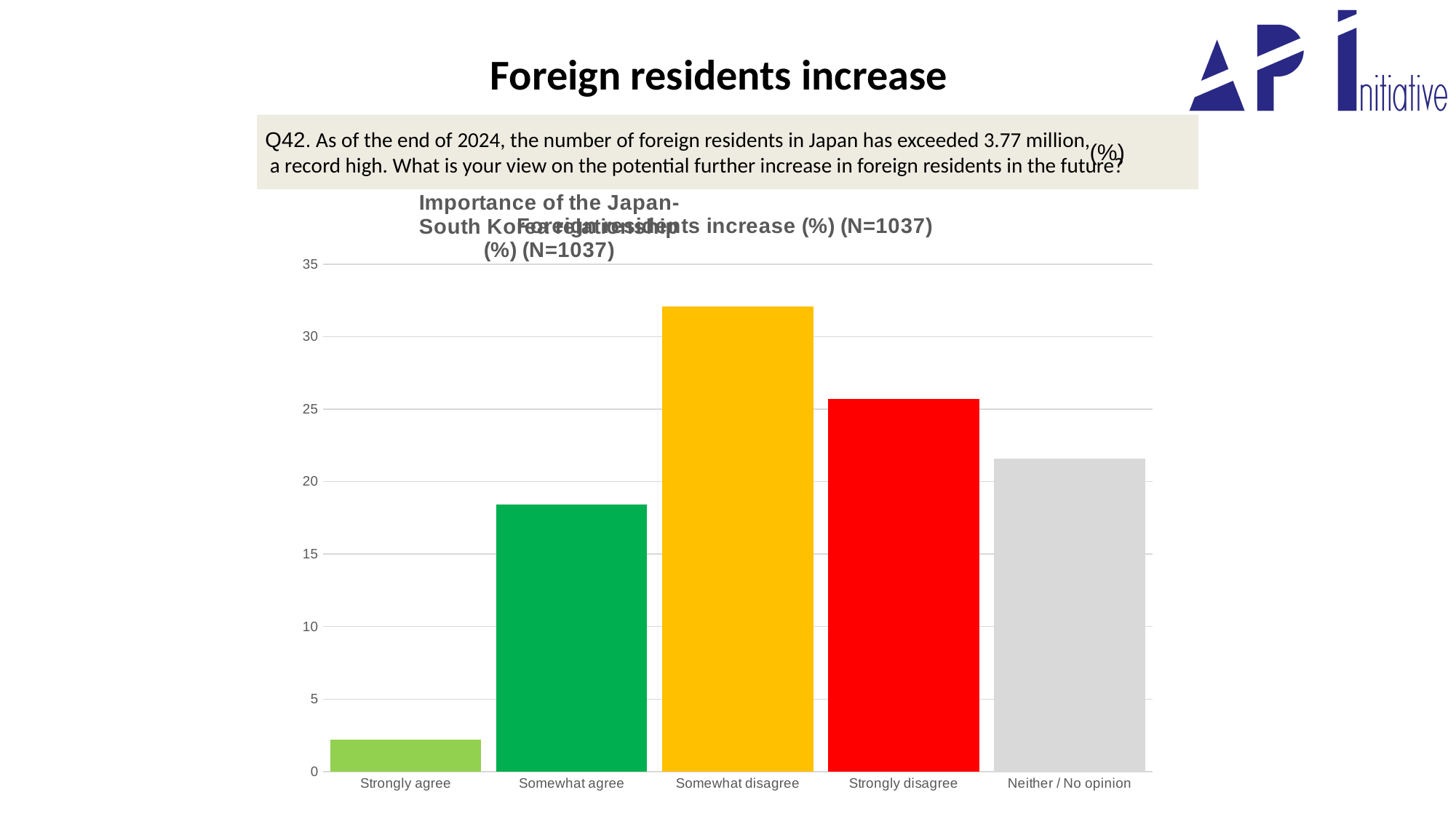
What kind of chart is shown on the slide? bar chart Is the value for Strongly disagree greater or less than 30? less Which response category has the highest value in the chart? Somewhat disagree Which response category has the lowest value in the chart? Strongly agree Is the value for Neither / No opinion greater or less than 20? greater Which is larger, the value for Somewhat agree or the value for Neither / No opinion? Neither / No opinion Is the value for Strongly agree greater or less than 5? less How many response categories are shown on the x axis of the chart? 5 What colour is the bar for Somewhat disagree? yellow Which is larger, the value for Strongly disagree or the value for Neither / No opinion? Strongly disagree